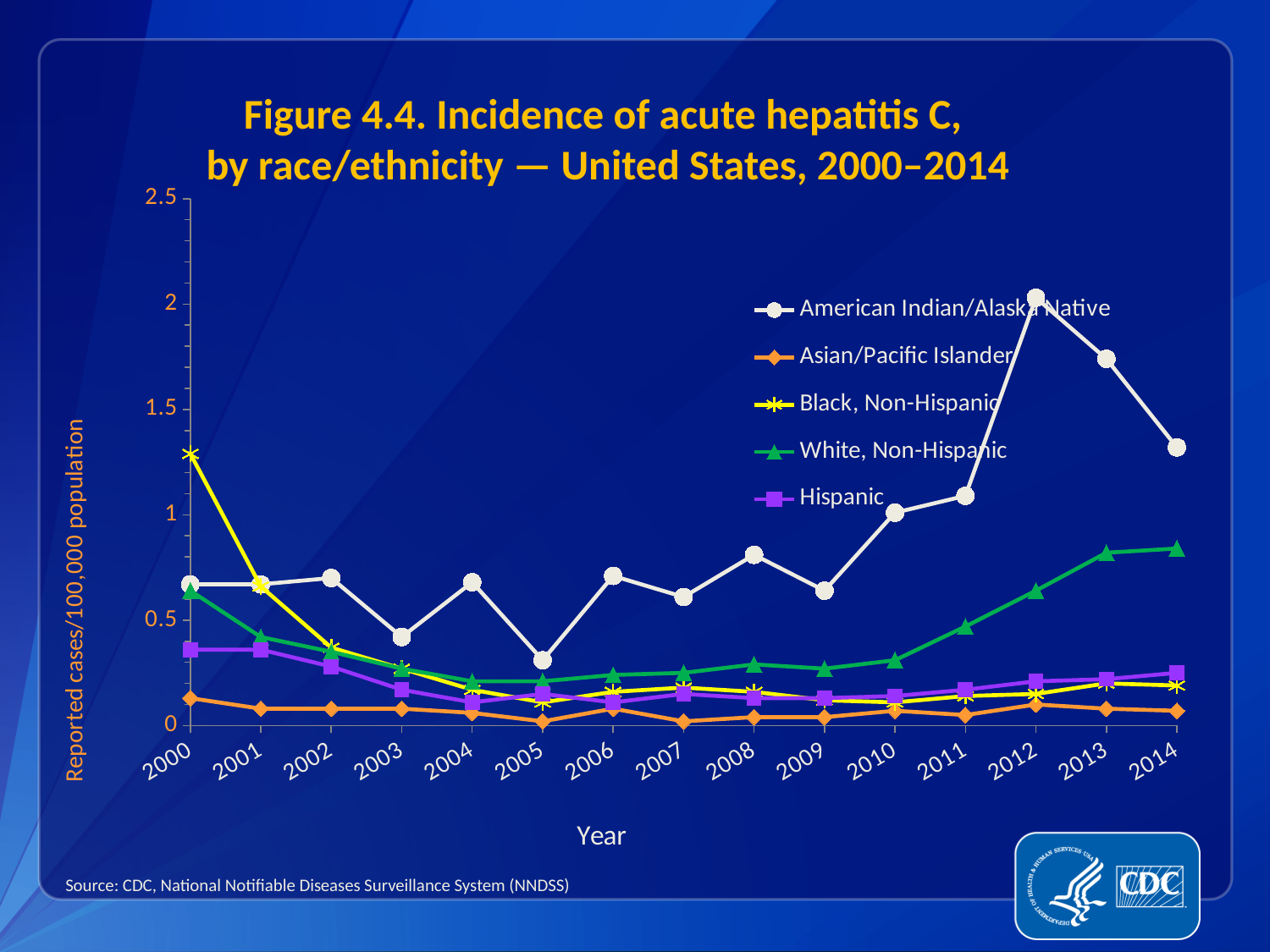
Is the value for White, Non-Hispanic in 2014 greater or less than 0.5? greater How many series does the legend list? 5 In 2014, which is larger: the value for American Indian/Alaska Native or the value for White, Non-Hispanic? American Indian/Alaska Native How many years are plotted along the x axis? 15 Is the value for American Indian/Alaska Native in 2012 greater or less than 1.5? greater Which race/ethnicity group has the highest incidence in 2000? Black, Non-Hispanic What kind of chart is shown on the slide? Line chart What is the label on the y axis? Reported cases/100,000 population Which race/ethnicity group has the lowest incidence in 2014? Asian/Pacific Islander Does the White, Non-Hispanic line rise or fall from 2010 to 2014? Rise Is the value for Black, Non-Hispanic in 2000 greater or less than 1? greater Which race/ethnicity group has the highest incidence in 2012? American Indian/Alaska Native